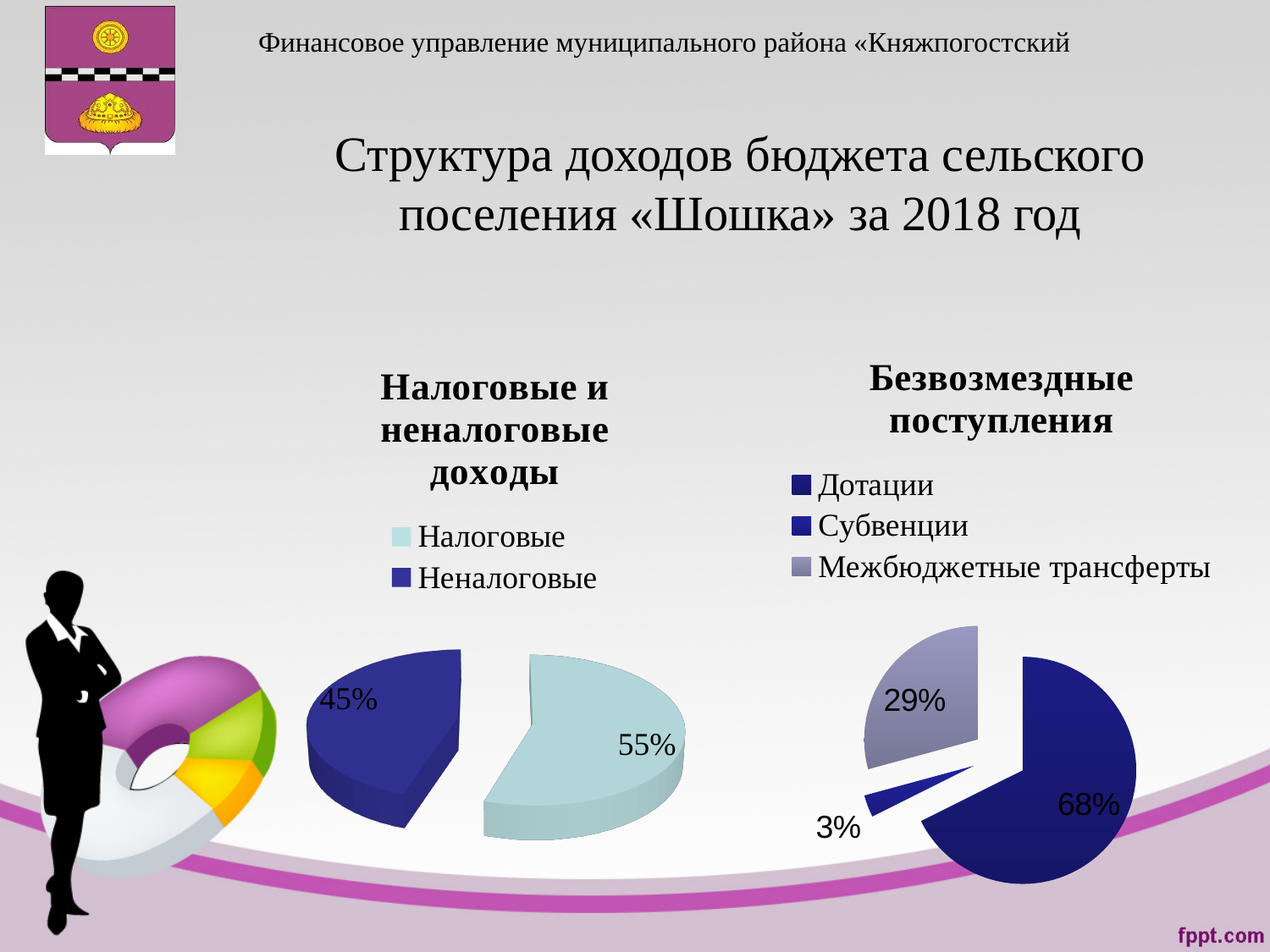
What type of chart is the one titled «Безвозмездные поступления»? Pie chart In the chart titled «Налоговые и неналоговые доходы», what share do Неналоговые revenues have? 45% In the chart titled «Безвозмездные поступления», what is the difference in percentage points between Дотации and Межбюджетные трансферты? 39 In the chart titled «Безвозмездные поступления», how many categories does the legend list? 3 In the chart titled «Налоговые и неналоговые доходы», what is the difference in percentage points between Налоговые and Неналоговые? 10 In the chart titled «Безвозмездные поступления», which category has the smallest share? Субвенции In the chart titled «Безвозмездные поступления», what share do Субвенции have? 3% In the chart titled «Безвозмездные поступления», what share do Межбюджетные трансферты have? 29% In the chart titled «Безвозмездные поступления», what share do Дотации have? 68% In the chart titled «Налоговые и неналоговые доходы», which category has the larger share? Налоговые In the chart titled «Налоговые и неналоговые доходы», what share do Налоговые revenues have? 55% In the chart titled «Безвозмездные поступления», which category has the largest share? Дотации